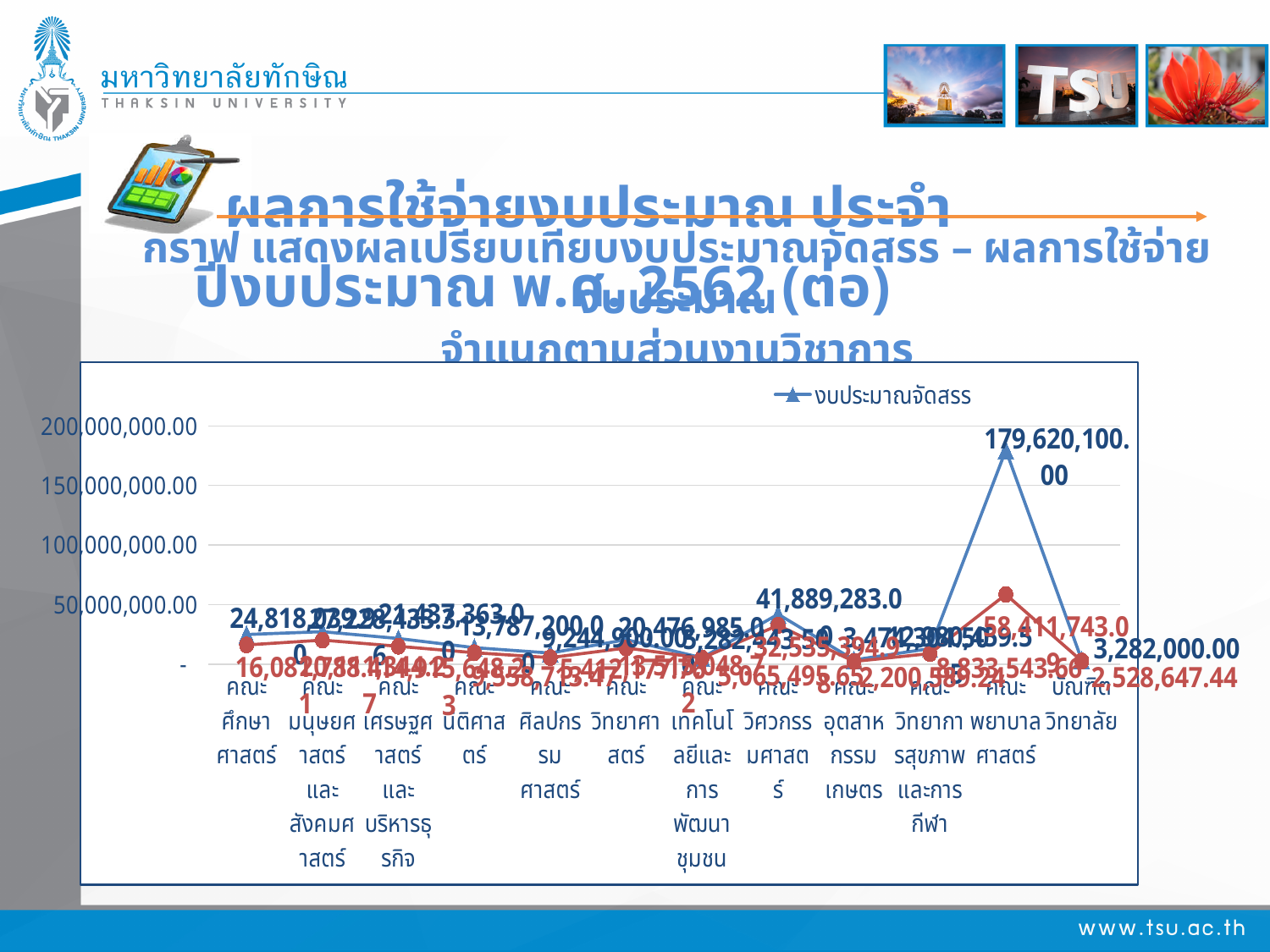
What is the difference between the งบประมาณจัดสรร value and the red series value for บัณฑิตวิทยาลัย? 753,352.56 What is the value of the red series for บัณฑิตวิทยาลัย? 2,528,647.44 How many categories (faculties/units) are shown on the x axis of the chart? 12 What is the งบประมาณจัดสรร value for คณะพยาบาลศาสตร์? 179,620,100.00 Which category has the highest งบประมาณจัดสรร value in the chart? คณะพยาบาลศาสตร์ Is the งบประมาณจัดสรร value for คณะพยาบาลศาสตร์ greater or less than 150,000,000.00? greater For บัณฑิตวิทยาลัย, which is larger: the งบประมาณจัดสรร value or the red series value? งบประมาณจัดสรร What is the งบประมาณจัดสรร value for บัณฑิตวิทยาลัย? 3,282,000.00 What series name is shown in the chart legend? งบประมาณจัดสรร What kind of chart is shown on the slide? line chart Is the red series value for คณะพยาบาลศาสตร์ greater or less than 100,000,000.00? less Is the งบประมาณจัดสรร value for คณะวิศวกรรมศาสตร์ greater or less than 50,000,000.00? less